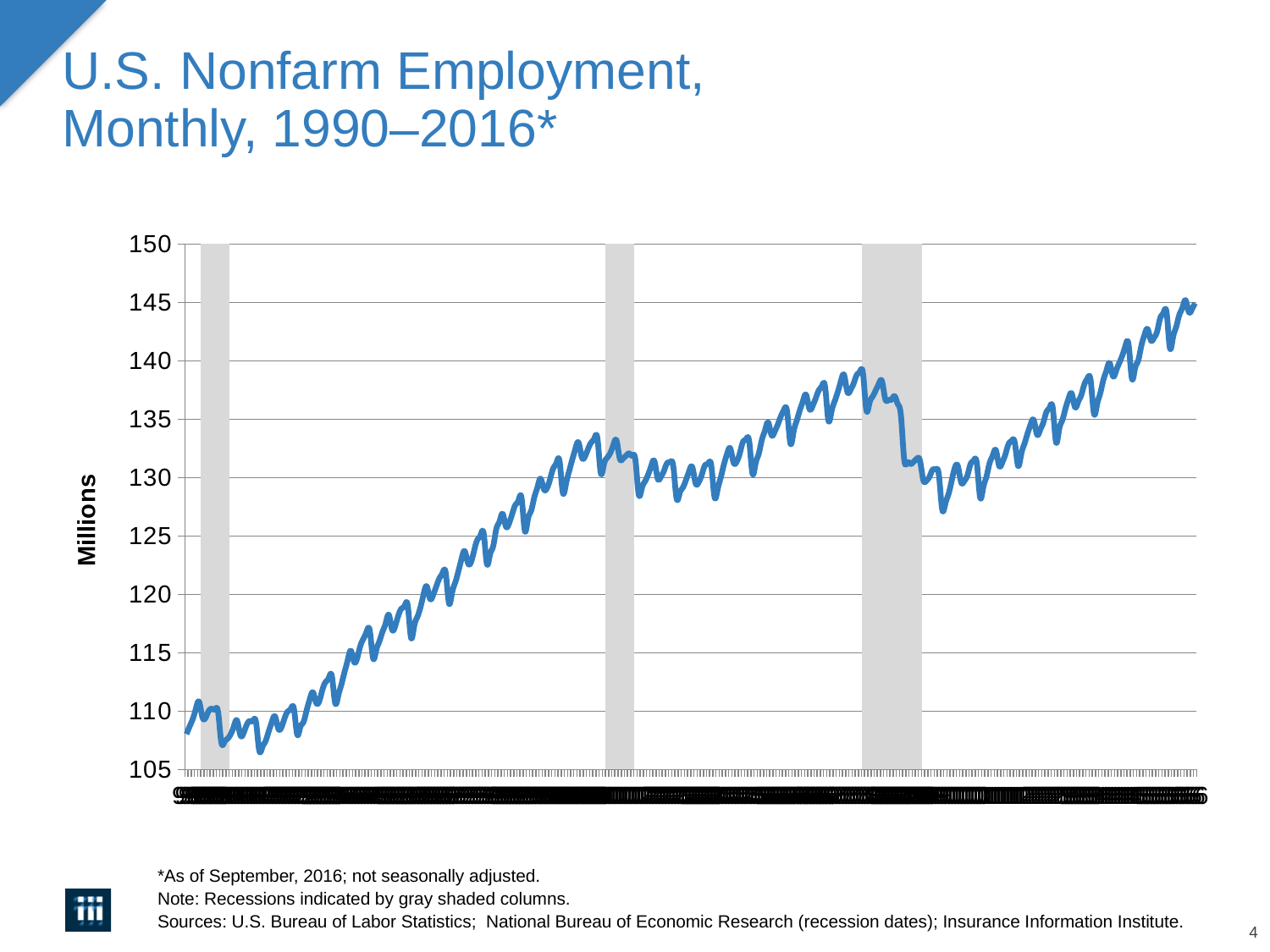
Is the lowest value on the chart greater or less than 110? less How many data series are plotted on the chart? 1 What is the highest value shown on the vertical axis? 150 Is the highest value on the chart greater or less than 140? greater What is the label on the vertical axis of the chart? Millions Is the value at the start of the series (left edge of the chart) greater or less than 110? less Is the value at the end of the series larger or smaller than the value at the start of the series? Larger Overall, do the values rise or fall from the left to the right of the chart? Rise How many gray shaded recession columns are shown on the chart? 3 What is the title of the chart? U.S. Nonfarm Employment, Monthly, 1990–2016* What kind of chart is shown on the slide? Line chart